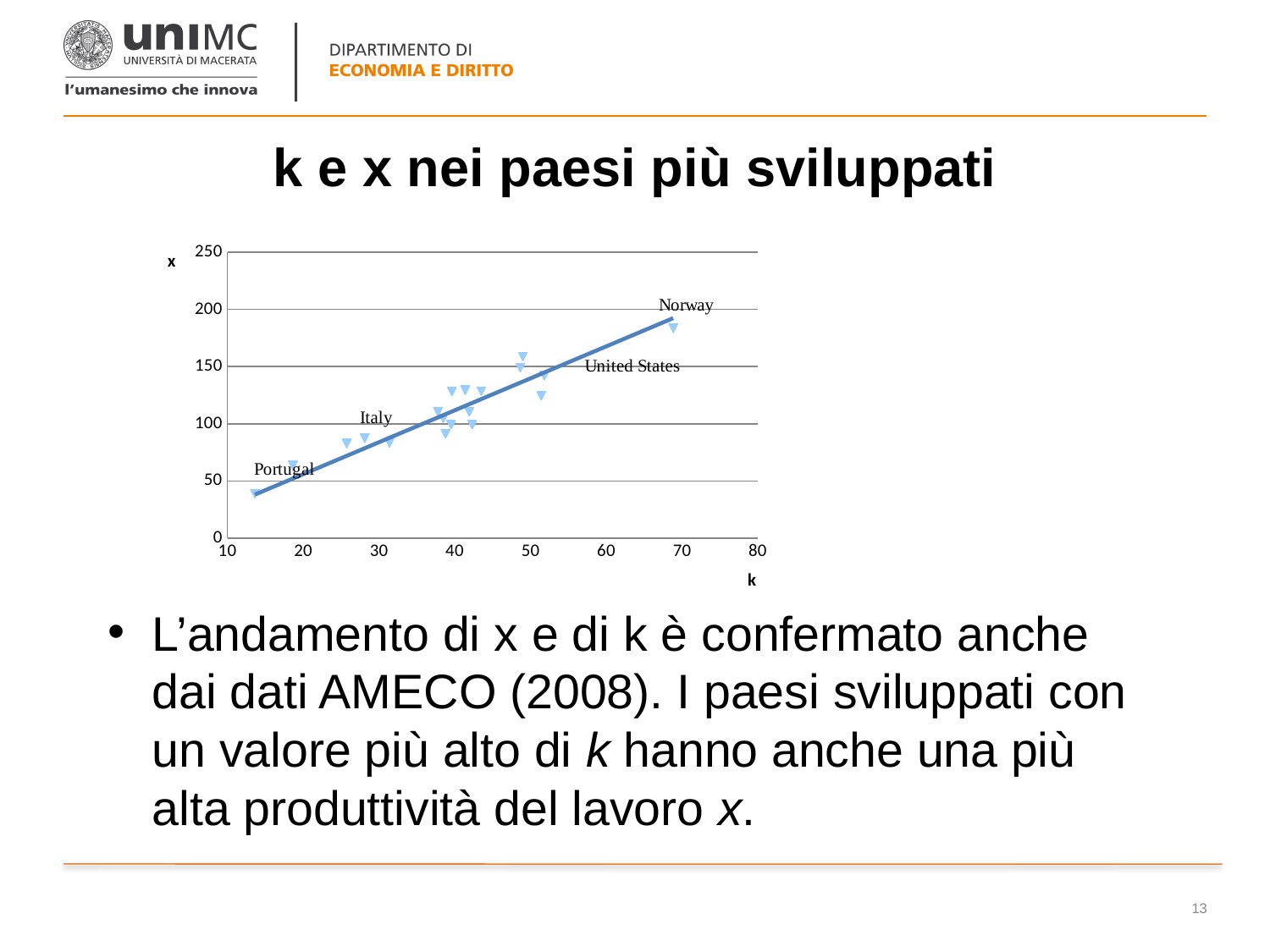
Which labelled country has the lowest x value in the chart? Portugal Which has a higher x value, Italy or Portugal? Italy What kind of chart is shown on the slide? scatter plot Is the k value for Norway greater or less than 60? greater What is the title of the chart? k e x nei paesi più sviluppati Is the x value for Norway greater or less than 150? greater Is the x value for Norway greater or less than 200? less Which labelled country has the highest x value in the chart? Norway What label is shown on the vertical axis of the chart? x As k increases along the horizontal axis, do the x values generally rise or fall? rise